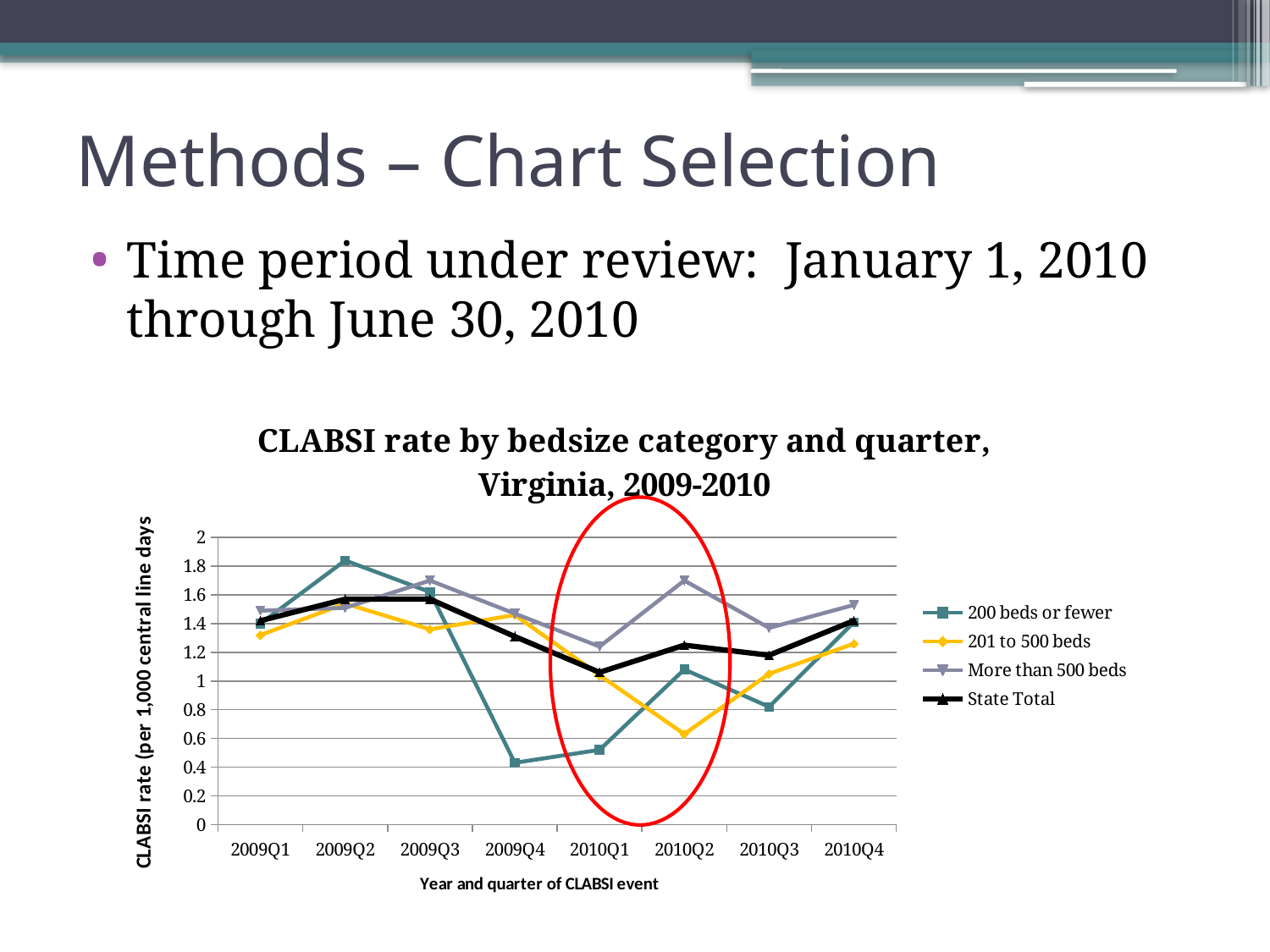
What kind of chart is shown on the slide? line chart In 2009Q4, which is larger: the value for 200 beds or fewer or the value for More than 500 beds? More than 500 beds Is the value for 200 beds or fewer in 2009Q2 greater or less than 1.6? greater Does the State Total series rise or fall from 2009Q3 to 2010Q1? fall How many quarters are plotted along the x axis? 8 In which quarter does the 200 beds or fewer series reach its lowest value? 2009Q4 Is the value for 201 to 500 beds in 2010Q2 greater or less than 0.8? less Is the value for 200 beds or fewer in 2009Q4 greater or less than 0.6? less Which quarters are enclosed by the red oval on the chart? 2010Q1 and 2010Q2 Which series has the highest value in 2010Q2? More than 500 beds How many series does the legend list? 4